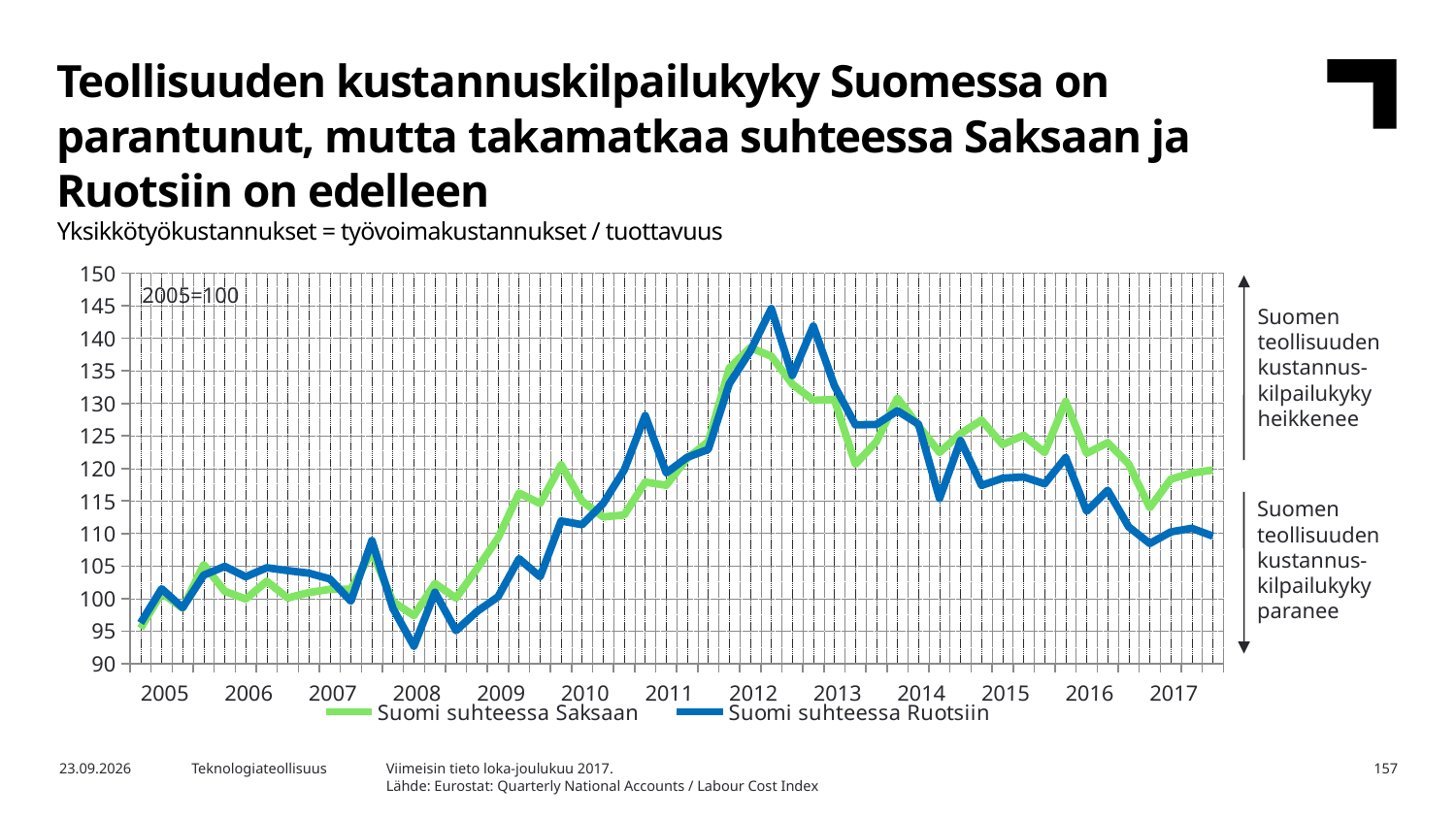
Is the peak value of the Suomi suhteessa Saksaan series in 2012 greater or less than 140? less Which series is drawn in green? Suomi suhteessa Saksaan Do the values of the Suomi suhteessa Ruotsiin series generally rise or fall from 2012 to 2017? fall Is the lowest value of the Suomi suhteessa Ruotsiin series in 2008 greater or less than 95? less At the 2012 peak, which series reaches the higher value, Suomi suhteessa Saksaan or Suomi suhteessa Ruotsiin? Suomi suhteessa Ruotsiin How many year labels are shown on the x axis? 13 Is the value of the Suomi suhteessa Saksaan series at the end of 2017 greater or less than 115? greater At the end of 2017, which series has the higher value, Suomi suhteessa Saksaan or Suomi suhteessa Ruotsiin? Suomi suhteessa Saksaan What kind of chart is shown on the slide? line chart How many series does the legend list? 2 What base-year annotation is printed inside the chart area? 2005=100